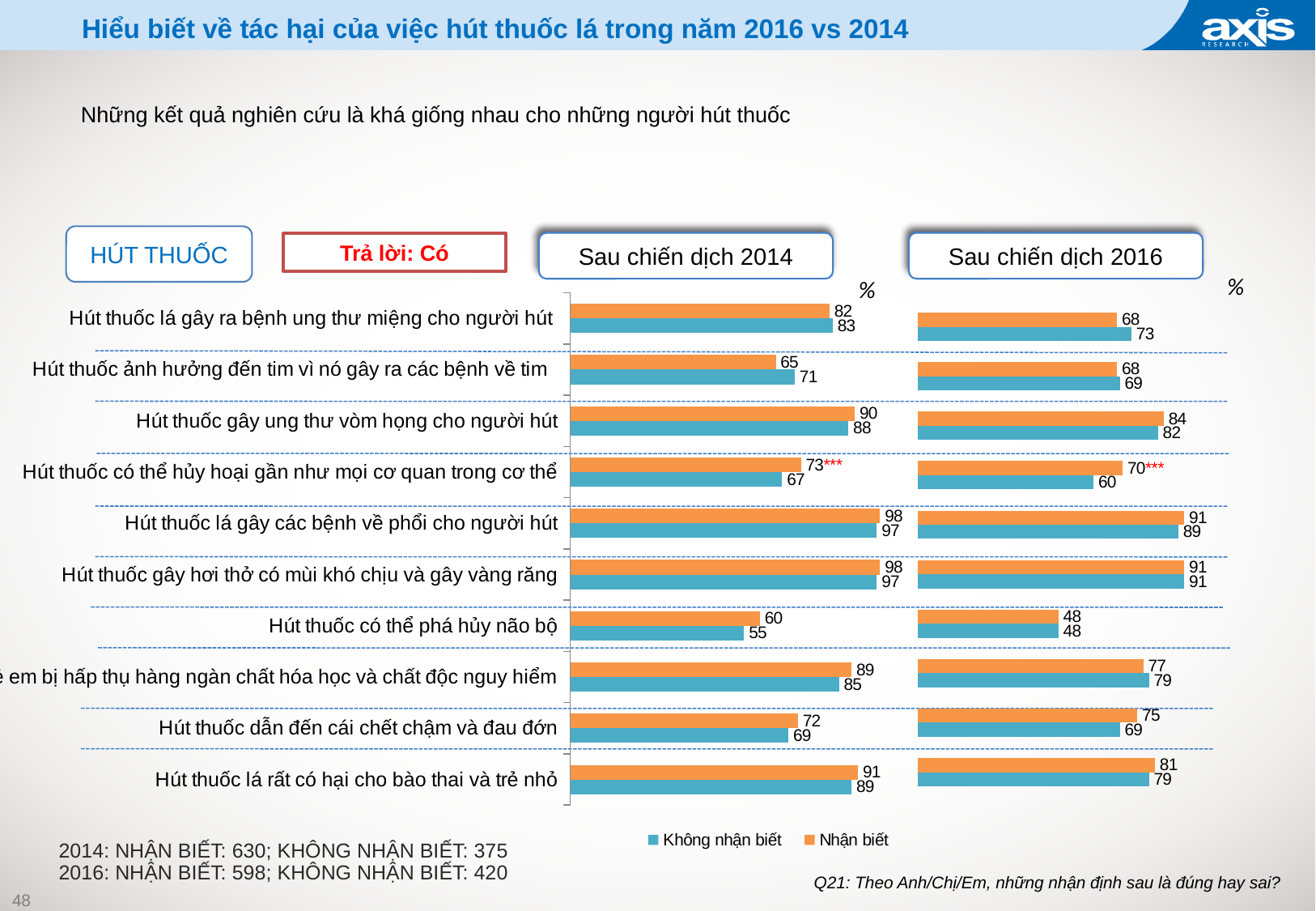
How many series does the legend list for the charts? 2 In the 'Sau chiến dịch 2016' chart, what is the difference between the 'Nhận biết' and 'Không nhận biết' values for 'Hút thuốc có thể hủy hoại gần như mọi cơ quan trong cơ thể'? 10 In the 'Sau chiến dịch 2016' chart, which category has the lowest 'Nhận biết' value? Hút thuốc có thể phá hủy não bộ What type of chart is the 'Sau chiến dịch 2016' chart? Bar chart In the 'Sau chiến dịch 2016' chart, which is larger for 'Hút thuốc lá rất có hại cho bào thai và trẻ nhỏ': 'Nhận biết' or 'Không nhận biết'? Nhận biết In the 'Sau chiến dịch 2014' chart, what is the 'Nhận biết' value for 'Hút thuốc có thể phá hủy não bộ'? 60 In the 'Sau chiến dịch 2016' chart, what is the 'Không nhận biết' value for 'Hút thuốc lá gây ra bệnh ung thư miệng cho người hút'? 73 In the 'Sau chiến dịch 2014' chart, which category has the lowest 'Không nhận biết' value? Hút thuốc có thể phá hủy não bộ In the 'Sau chiến dịch 2016' chart, what is the 'Nhận biết' value for 'Hút thuốc dẫn đến cái chết chậm và đau đớn'? 75 In the 'Sau chiến dịch 2014' chart, what is the difference between the 'Nhận biết' and 'Không nhận biết' values for 'Hút thuốc ảnh hưởng đến tim vì nó gây ra các bệnh về tim'? 6 How many categories are shown in the 'Sau chiến dịch 2014' chart? 10 In the 'Sau chiến dịch 2014' chart, which is larger for 'Hút thuốc gây ung thư vòm họng cho người hút': 'Nhận biết' or 'Không nhận biết'? Nhận biết